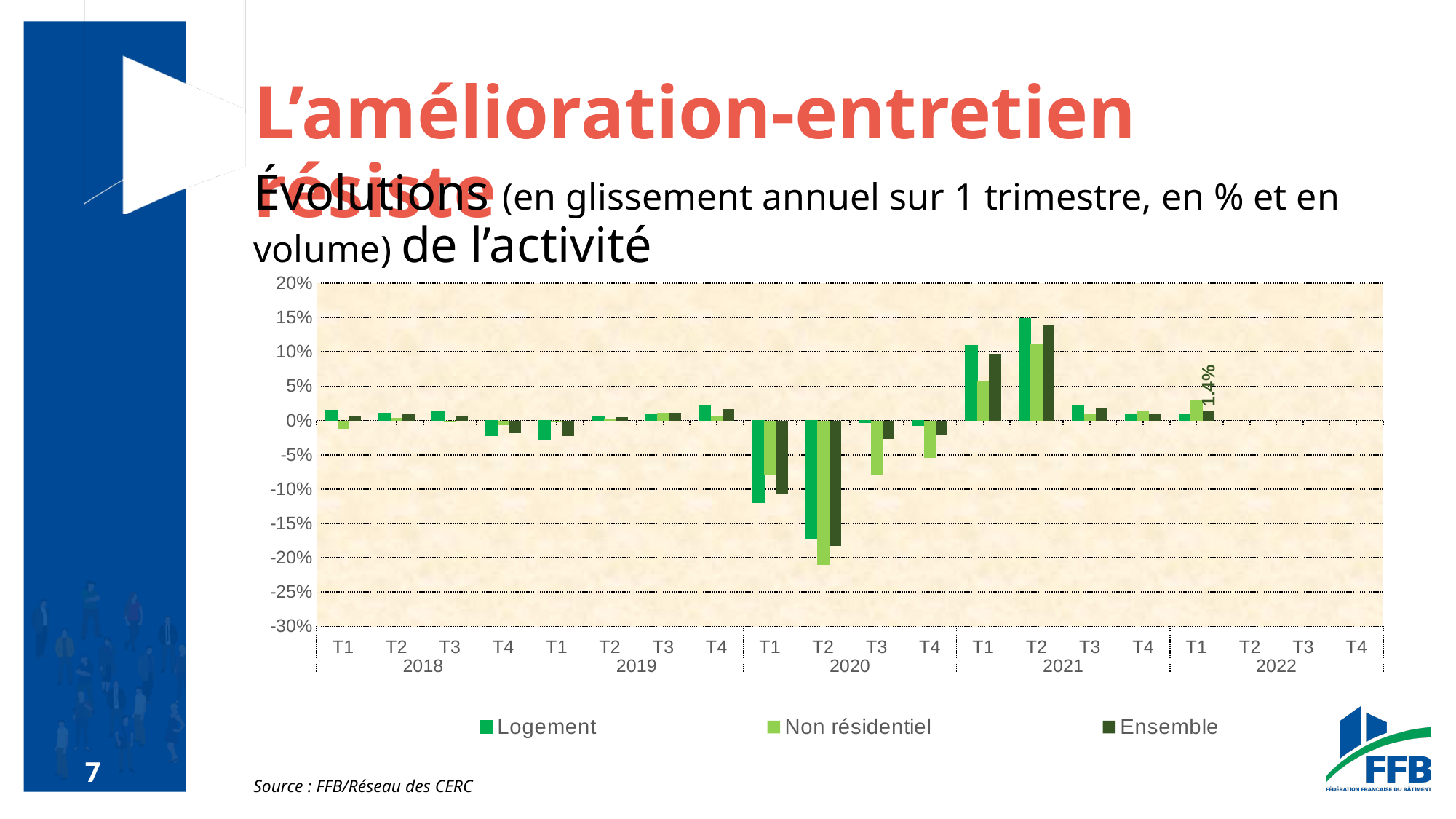
What is the value of the Ensemble series for T1 2022? 1.4% Which series has the lowest value in T2 2020? Non résidentiel Does the Logement series rise or fall from T1 2020 to T2 2020? Fall Is the value for Non résidentiel in T2 2020 greater or less than -15%? less Is the value for Ensemble in T1 2020 greater or less than -5%? less In T1 2021, which is larger: Logement or Non résidentiel? Logement How many years are shown on the x axis? 5 What source is cited below the chart? FFB/Réseau des CERC What kind of chart is shown on the slide? Bar chart Is the value for Logement in T2 2021 greater or less than 10%? greater How many series does the legend list? 3 Which series has the highest value in T2 2021? Logement